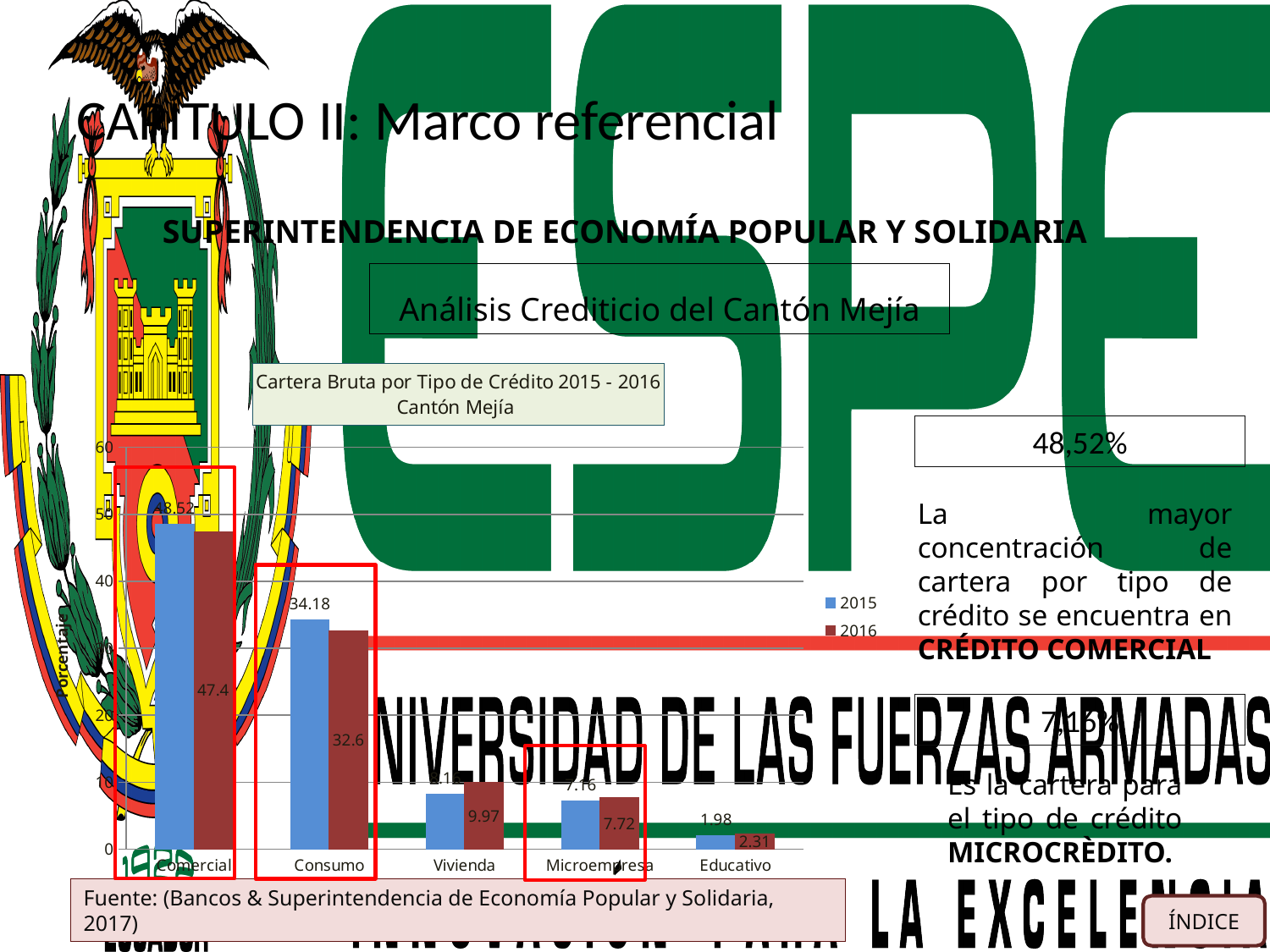
Which is larger for Microempresa, the 2015 value or the 2016 value? 2016 Which category has the highest 2015 value? Comercial What is the 2015 value for Consumo? 34.18 How many series does the chart legend list? 2 How many credit-type categories are shown on the x axis of the chart? 5 What is the 2016 value for Educativo? 2.31 What is the difference between the 2015 and 2016 values for Consumo? 1.58 What is the 2015 value for Comercial? 48.52 Which category has the lowest 2016 value? Educativo What type of chart is shown on the slide? bar chart What is the 2016 value for Comercial? 47.4 What is the 2016 value for Microempresa? 7.72